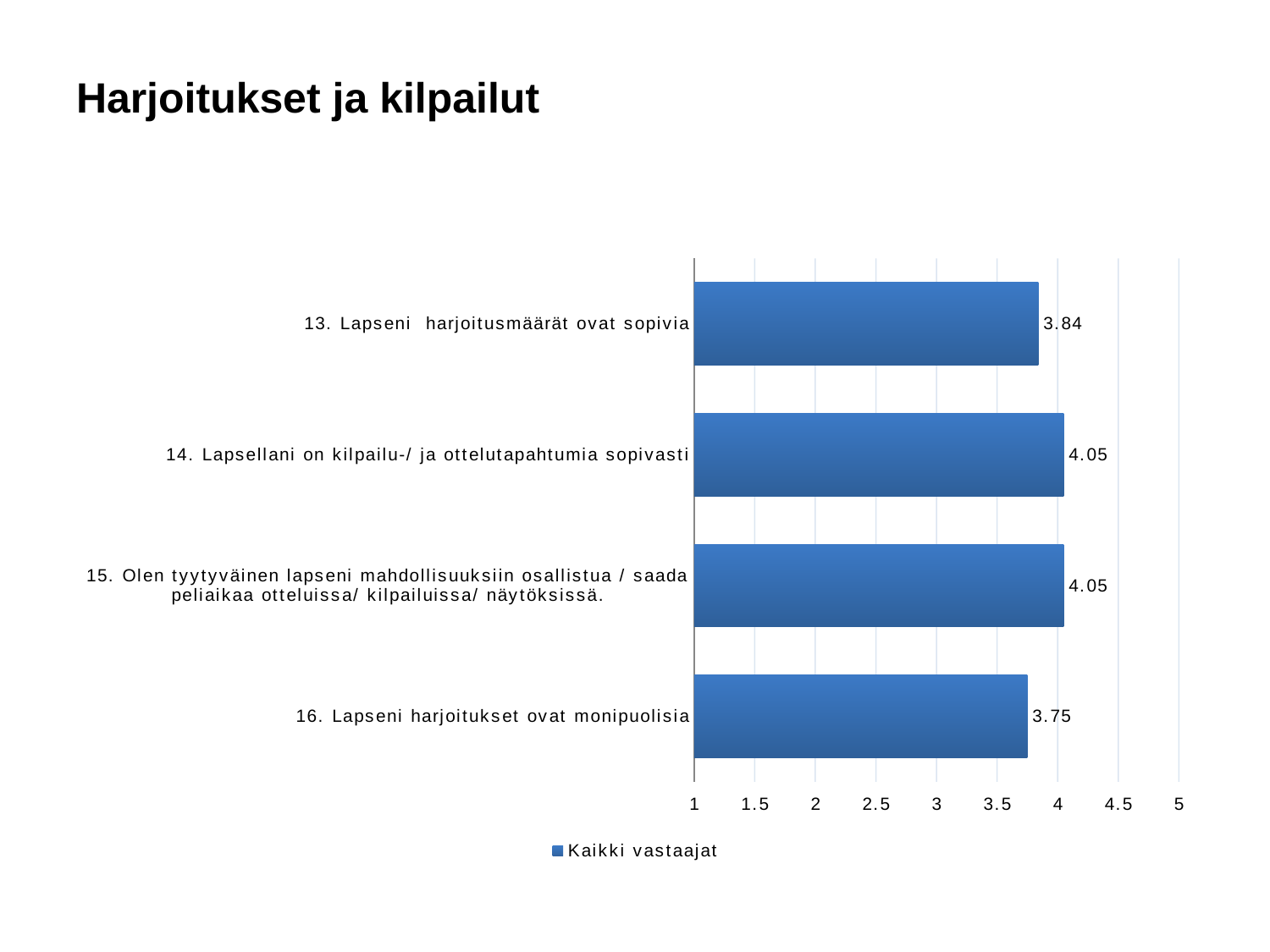
What is the value for "16. Lapseni harjoitukset ovat monipuolisia"? 3.75 What kind of chart is shown on the slide? Bar chart What is the difference between the values for item 13 and item 16? 0.09 Which is larger, the value for item 13 or the value for item 14? Item 14 Is the value for item 16 greater or less than 4? less How many series does the legend list? 1 What is the value for "13. Lapseni harjoitusmäärät ovat sopivia"? 3.84 What is the value for "14. Lapsellani on kilpailu-/ ja ottelutapahtumia sopivasti"? 4.05 What is the name of the series shown in the legend? Kaikki vastaajat Which category has the lowest value? 16. Lapseni harjoitukset ovat monipuolisia What is the difference between the values for item 14 and item 16? 0.30 How many categories are shown in the chart? 4